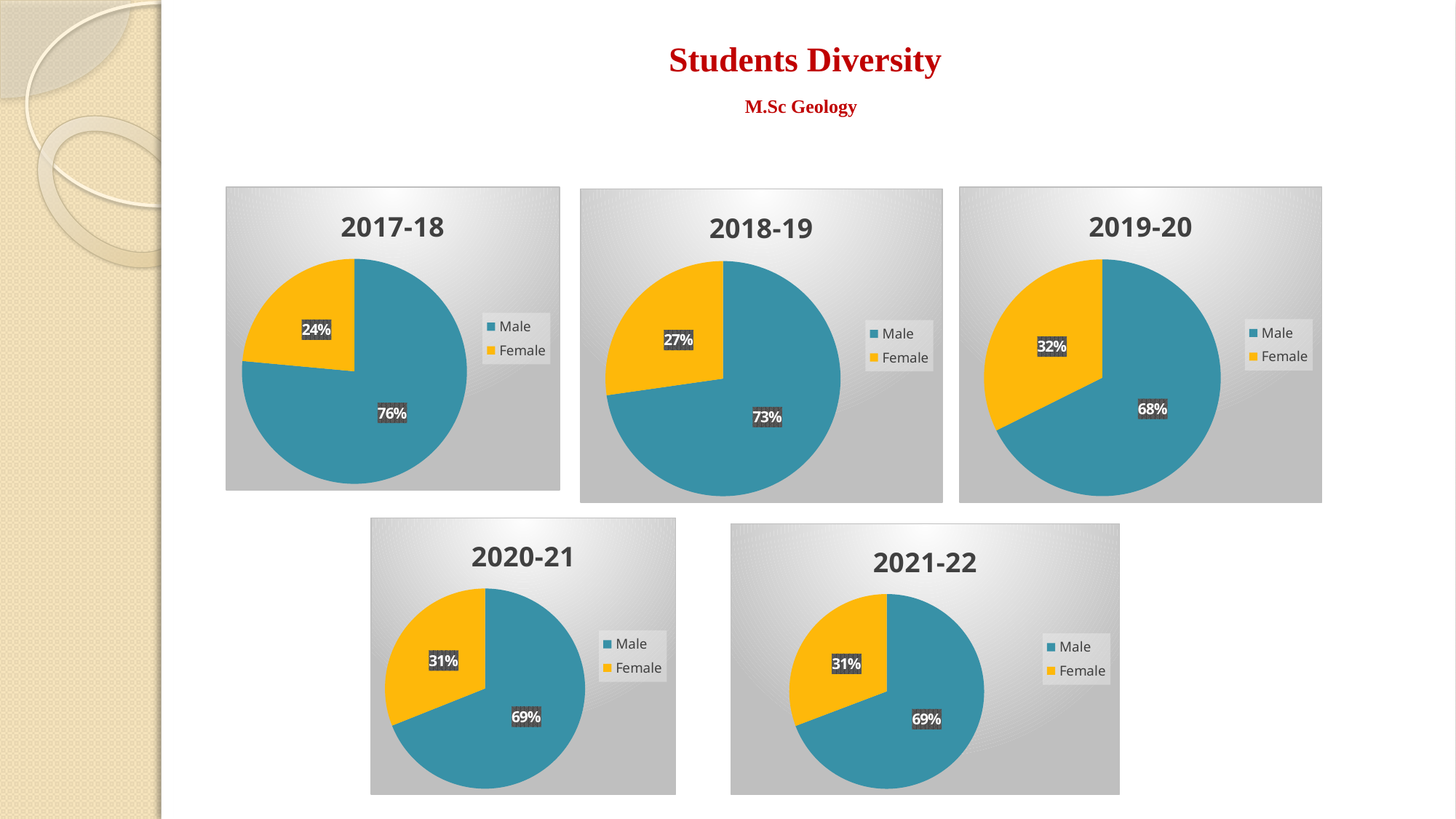
Which year's chart shows the lowest Female share? 2017-18 In the 2018-19 chart, what share of students is Male? 73% How many pie charts are shown on the slide? 5 In the 2019-20 chart, what share of students is Female? 32% What kind of chart is the 2020-21 chart? Pie chart How many entries does the legend of the 2018-19 chart list? 2 In the 2017-18 chart, what is the difference between the Male and Female shares? 52% In the 2017-18 chart, what share of students is Female? 24% In the 2019-20 chart, which slice is larger, Male or Female? Male Which year's chart shows the highest Female share? 2019-20